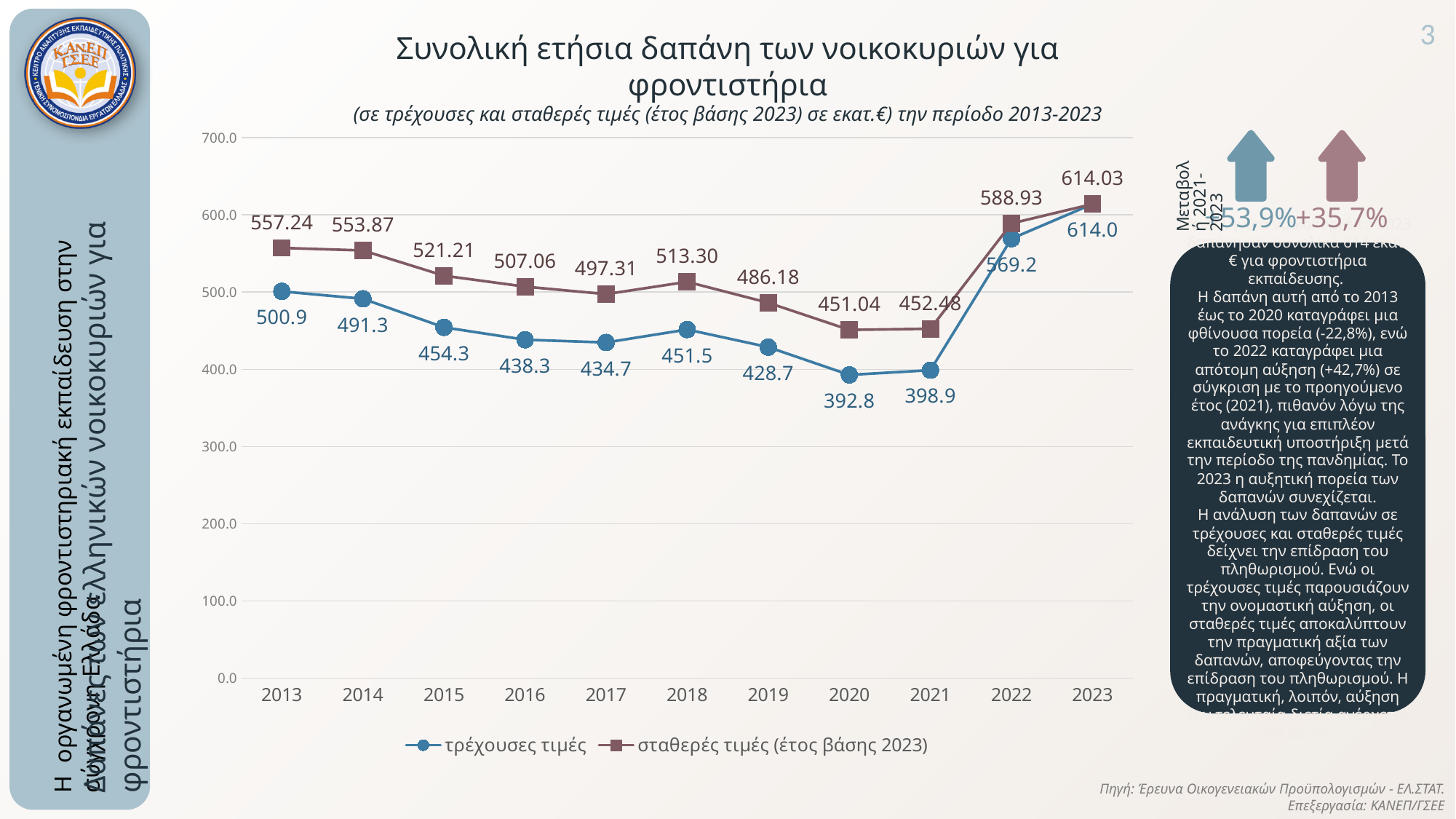
What is the difference between the σταθερές τιμές value in 2013 and the τρέχουσες τιμές value in 2013? 56.34 In which year is the τρέχουσες τιμές series at its lowest? 2020 Which is larger in 2018: the τρέχουσες τιμές value or the σταθερές τιμές value? σταθερές τιμές What is the value for τρέχουσες τιμές in 2020? 392.8 What type of chart is shown on the slide? line chart What is the value for τρέχουσες τιμές in 2022? 569.2 What is the percentage change shown next to the blue arrow at the right of the chart? +53,9% How many years are plotted on the x axis? 11 Does the τρέχουσες τιμές series rise or fall from 2013 to 2020? fall What is the value for σταθερές τιμές (έτος βάσης 2023) in 2015? 521.21 How many series does the legend list? 2 In which year is the σταθερές τιμές (έτος βάσης 2023) series at its highest? 2023